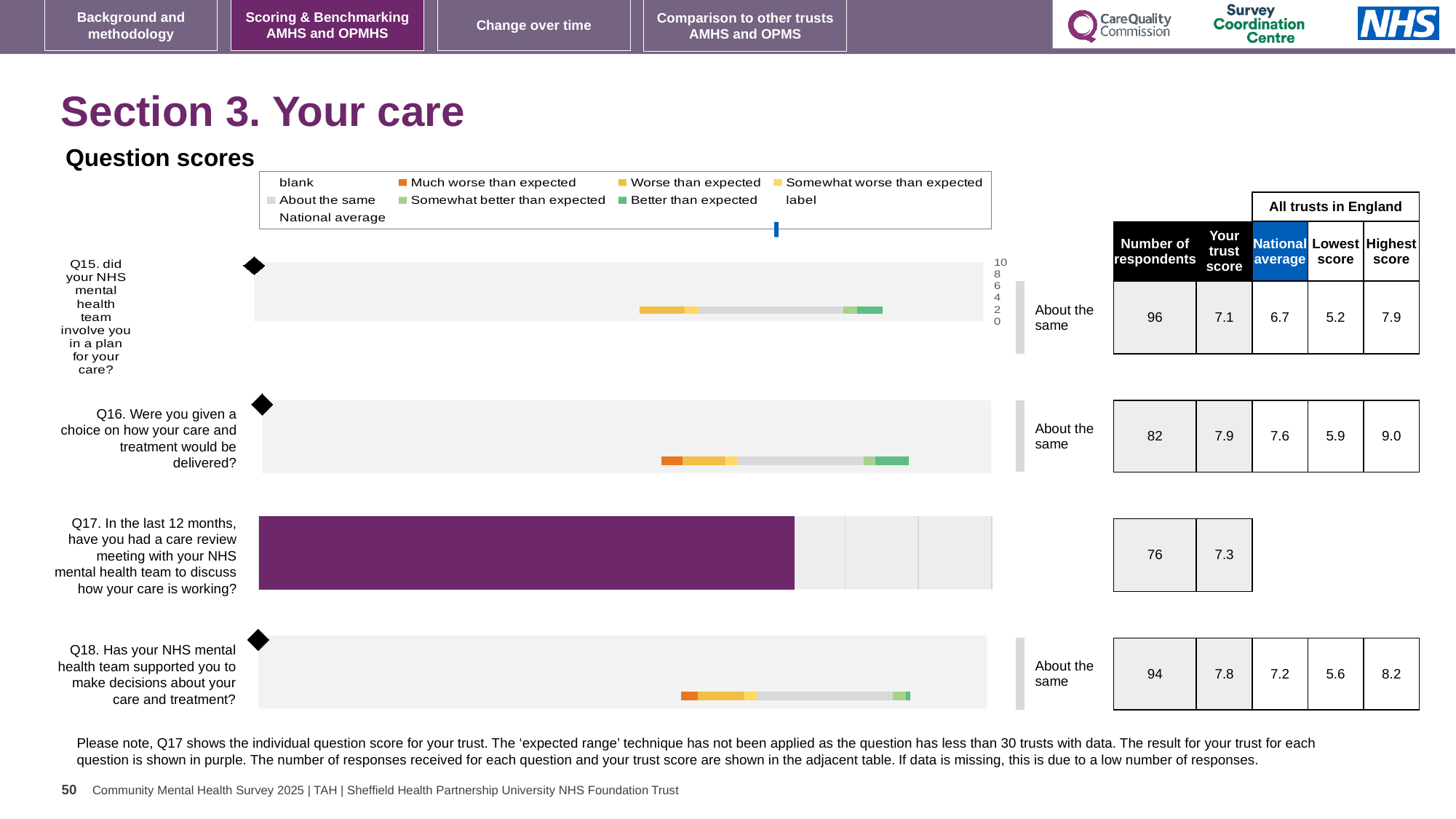
Which question has the highest trust score? Q16 What is the difference between the highest score and the lowest score for Q16? 3.1 How many respondents answered Q16 (were you given a choice on how your care and treatment would be delivered)? 82 What is the lowest score across all trusts in England for Q16? 5.9 By how much does the trust score for Q18 exceed the national average for Q18? 0.6 Which question's bar is shown in purple? Q17 How many questions are plotted in the chart? 4 Which question has the lowest number of respondents? Q17 What is the national average score for Q18 (has your NHS mental health team supported you to make decisions about your care and treatment)? 7.2 What is the trust score for Q15 (did your NHS mental health team involve you in a plan for your care)? 7.1 For Q15, which is larger: the trust score or the national average? Trust score What kind of chart is used to show the question scores? Bar chart